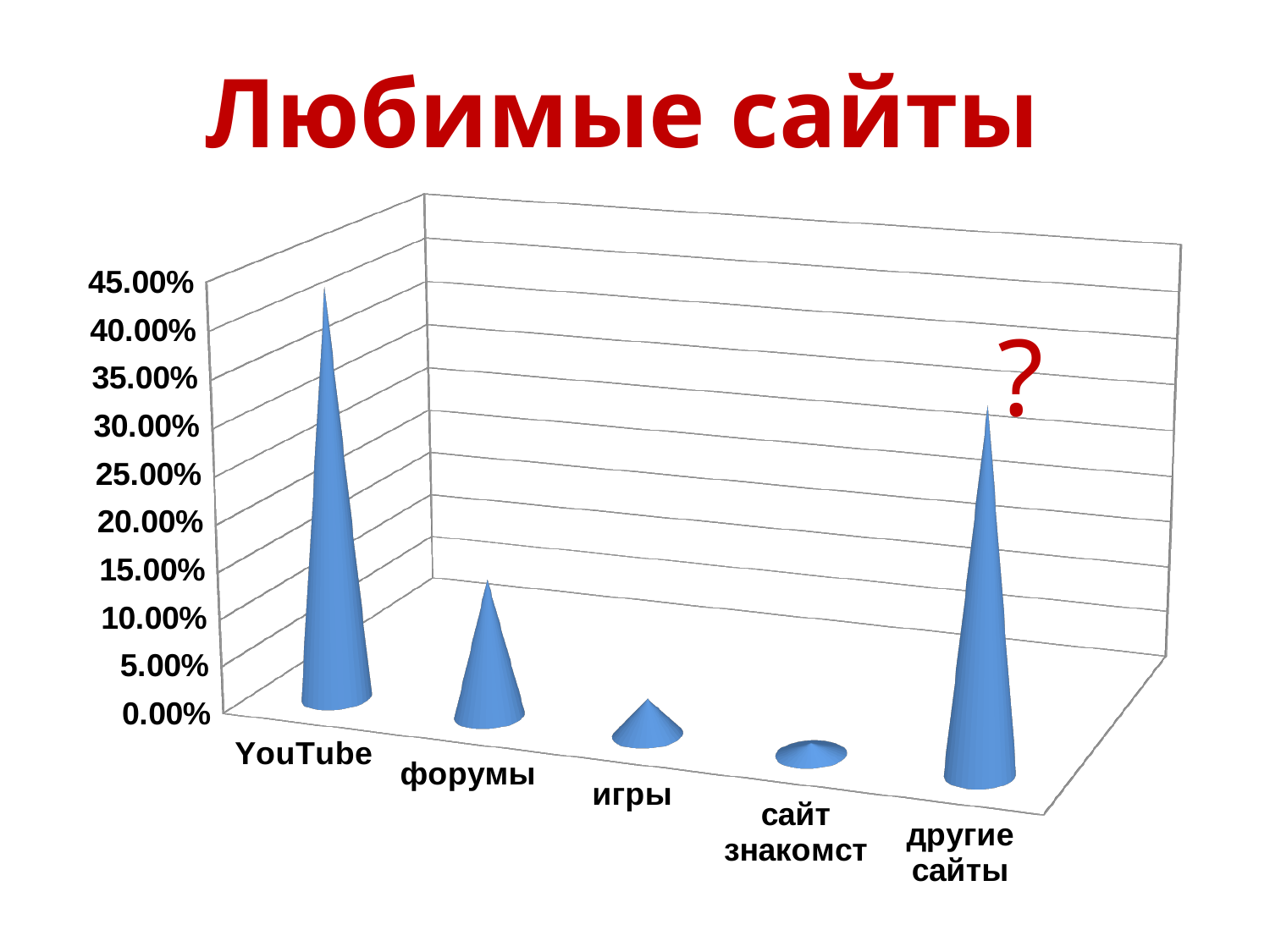
Is the value for игры greater or less than 10.00%? less Which is larger, the value for другие сайты or the value for игры? другие сайты Which is larger, the value for YouTube or the value for форумы? YouTube Is the value for YouTube greater or less than 30.00%? greater Which category has the lowest value? сайт знакомст What kind of chart is shown on the slide? bar chart Which category has the highest value? YouTube How many categories are shown on the x axis of the chart? 5 Is the value for форумы greater or less than 25.00%? less What is the title of the chart? Любимые сайты